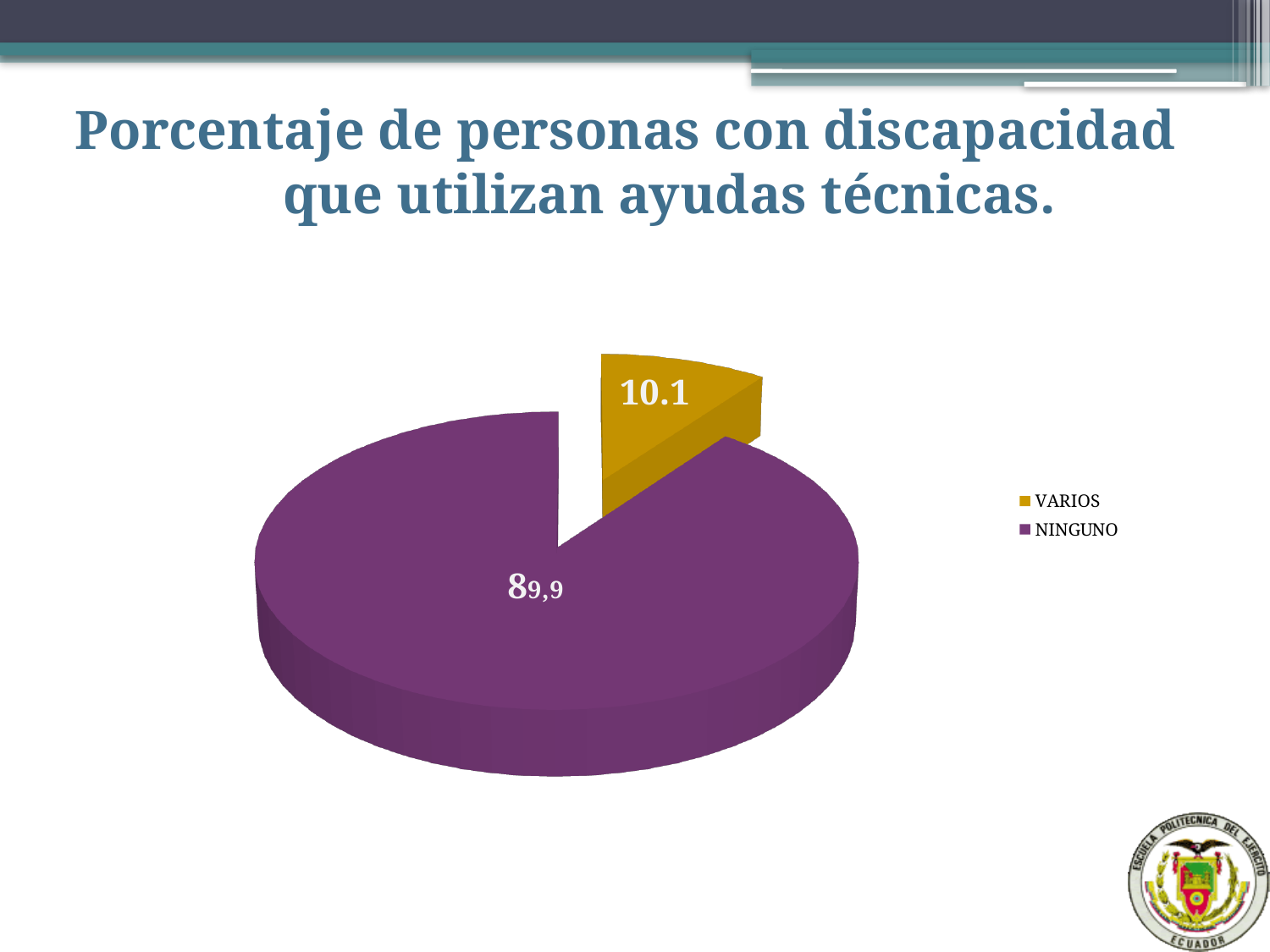
Which is larger, the VARIOS slice or the NINGUNO slice? NINGUNO What kind of chart is shown on the slide? pie chart What is the value shown for the NINGUNO slice? 89,9 How many slices does the pie chart have? 2 What is the title of the slide containing the chart? Porcentaje de personas con discapacidad que utilizan ayudas técnicas. What colour is the NINGUNO slice? purple How many entries does the legend list? 2 Which category has the largest slice of the pie? NINGUNO Which category has the smallest slice of the pie? VARIOS What is the value shown for the VARIOS slice? 10.1